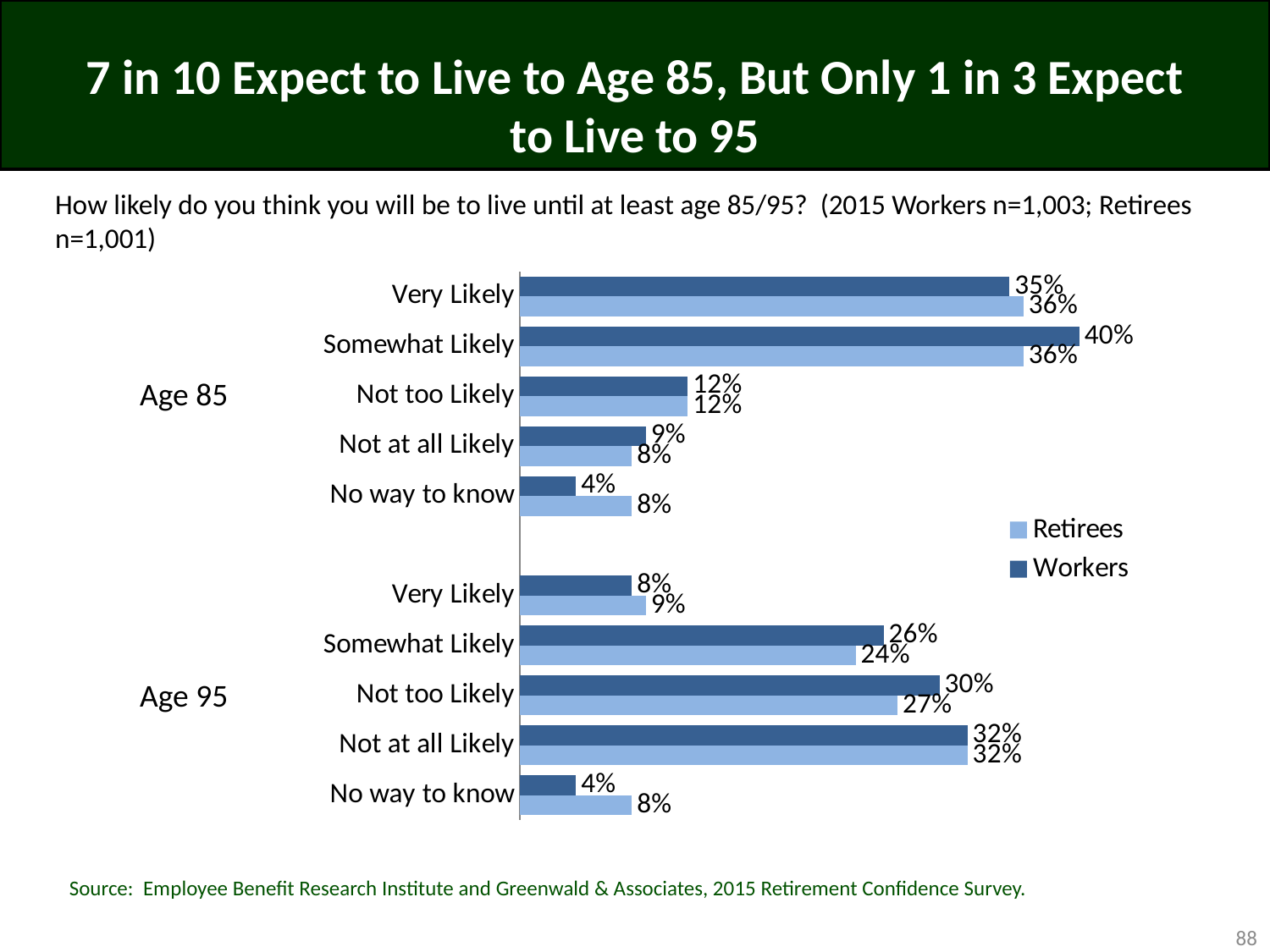
What percentage of Workers say they are Somewhat Likely to live to Age 85? 40% What is the difference between the Retirees and Workers percentages for No way to know at Age 95? 4% For Age 95, which response category has the highest percentage among Workers? Not at all Likely What percentage of Workers say they are Very Likely to live to Age 95? 8% Which series is shown in the lighter blue colour? Retirees What percentage of Retirees say they are Not too Likely to live to Age 95? 27% What kind of chart is shown on the slide? Bar chart For Age 85, which response category has the lowest percentage among Workers? No way to know For Age 95 Somewhat Likely, which group has the larger percentage, Workers or Retirees? Workers What is the difference between the Workers and Retirees percentages for Somewhat Likely at Age 85? 4% What percentage of Retirees say they are Very Likely to live to Age 85? 36% How many series does the legend list? 2